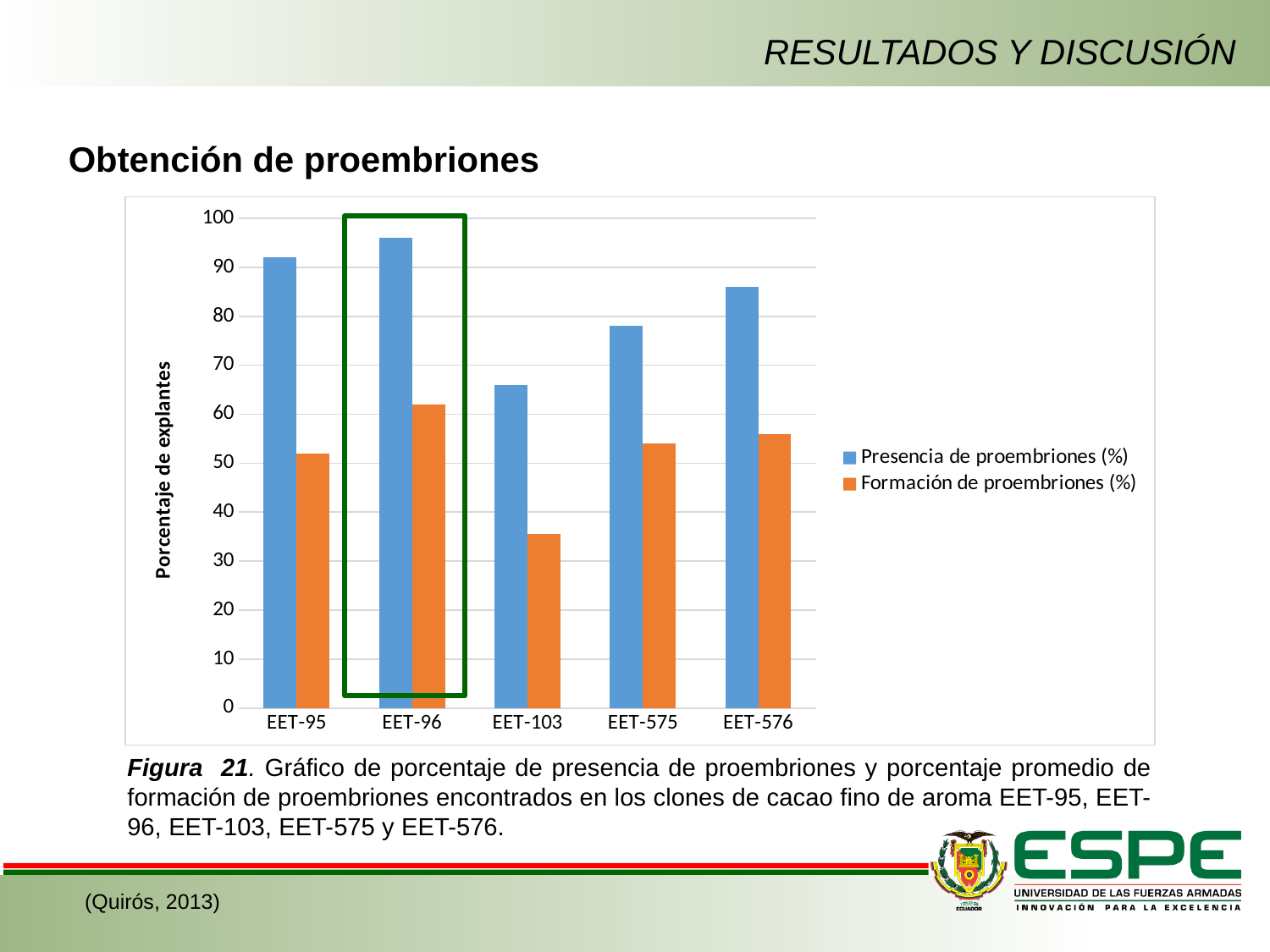
What is the label of the y axis? Porcentaje de explantes Which clone has the lowest value for Formación de proembriones (%)? EET-103 Which clone has the highest value for Presencia de proembriones (%)? EET-96 Which clone has the highest value for Formación de proembriones (%)? EET-96 Which is larger, the Presencia de proembriones (%) value for EET-95 or for EET-576? EET-95 How many series does the legend list? 2 Is the Presencia de proembriones (%) value for EET-576 greater or less than 80? greater Which clone has the lowest value for Presencia de proembriones (%)? EET-103 What kind of chart is shown on the slide? bar chart How many clones (categories) are shown on the x axis? 5 Is the Presencia de proembriones (%) value for EET-103 greater or less than 60? greater Is the Formación de proembriones (%) value for EET-103 greater or less than 40? less